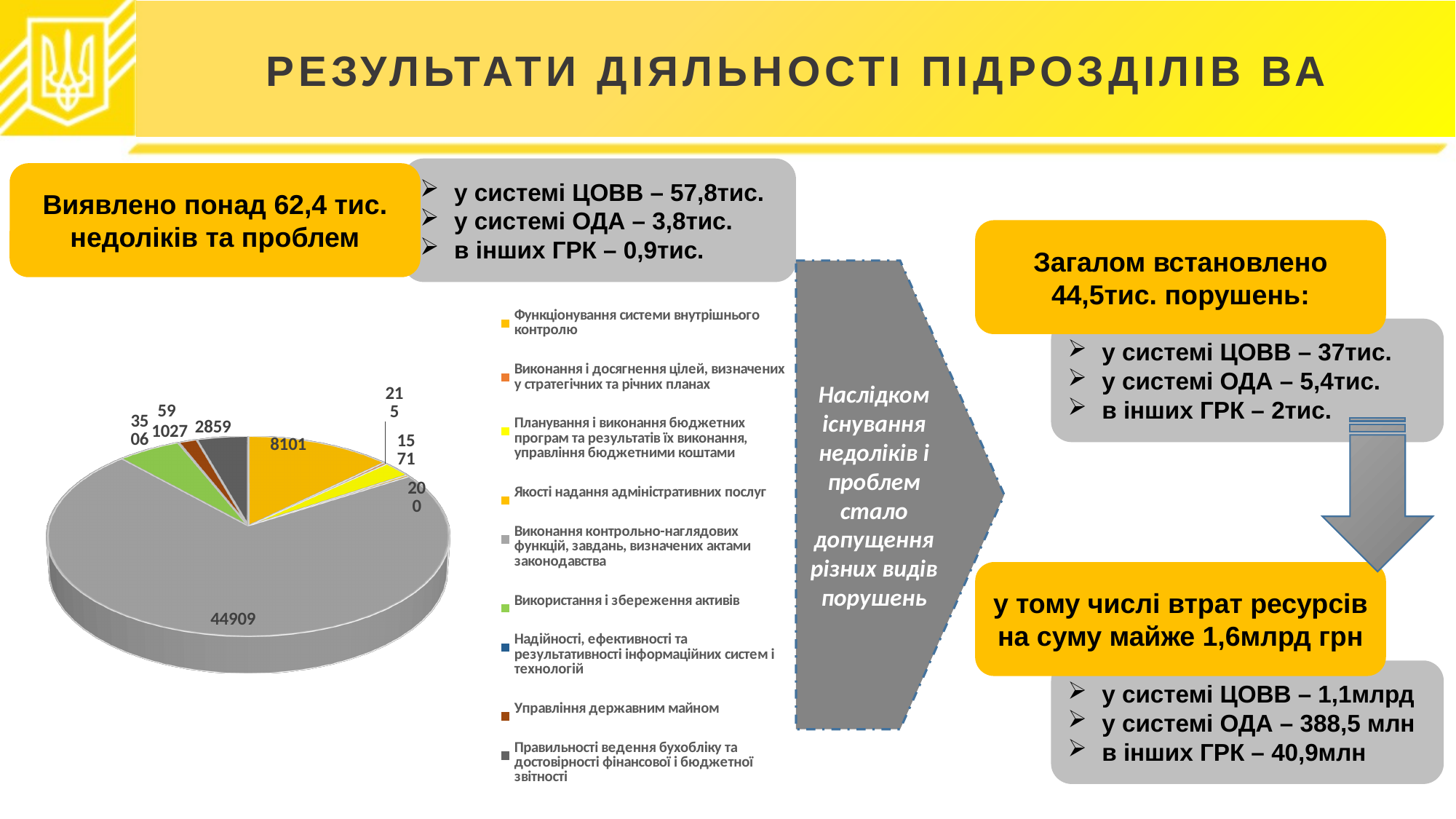
What is the value for 'Правильності ведення бухобліку та достовірності фінансової і бюджетної звітності' in the pie chart? 2859 What is the value for 'Використання і збереження активів' in the pie chart? 3506 What colour is the largest slice of the pie chart? grey Which category has the largest slice in the pie chart? Виконання контрольно-наглядових функцій, завдань, визначених актами законодавства What is the value for 'Функціонування системи внутрішнього контролю' in the pie chart? 8101 What kind of chart is shown on the slide? pie chart What is the difference between the values for 'Виконання контрольно-наглядових функцій' and 'Функціонування системи внутрішнього контролю' in the pie chart? 36808 Which is larger in the pie chart: the value for 'Функціонування системи внутрішнього контролю' or for 'Правильності ведення бухобліку'? Функціонування системи внутрішнього контролю What is the value for 'Управління державним майном' in the pie chart? 1027 Which is larger in the pie chart: the value for 'Використання і збереження активів' or for 'Управління державним майном'? Використання і збереження активів How many categories does the legend of the pie chart list? 9 What is the value of the largest slice in the pie chart? 44909